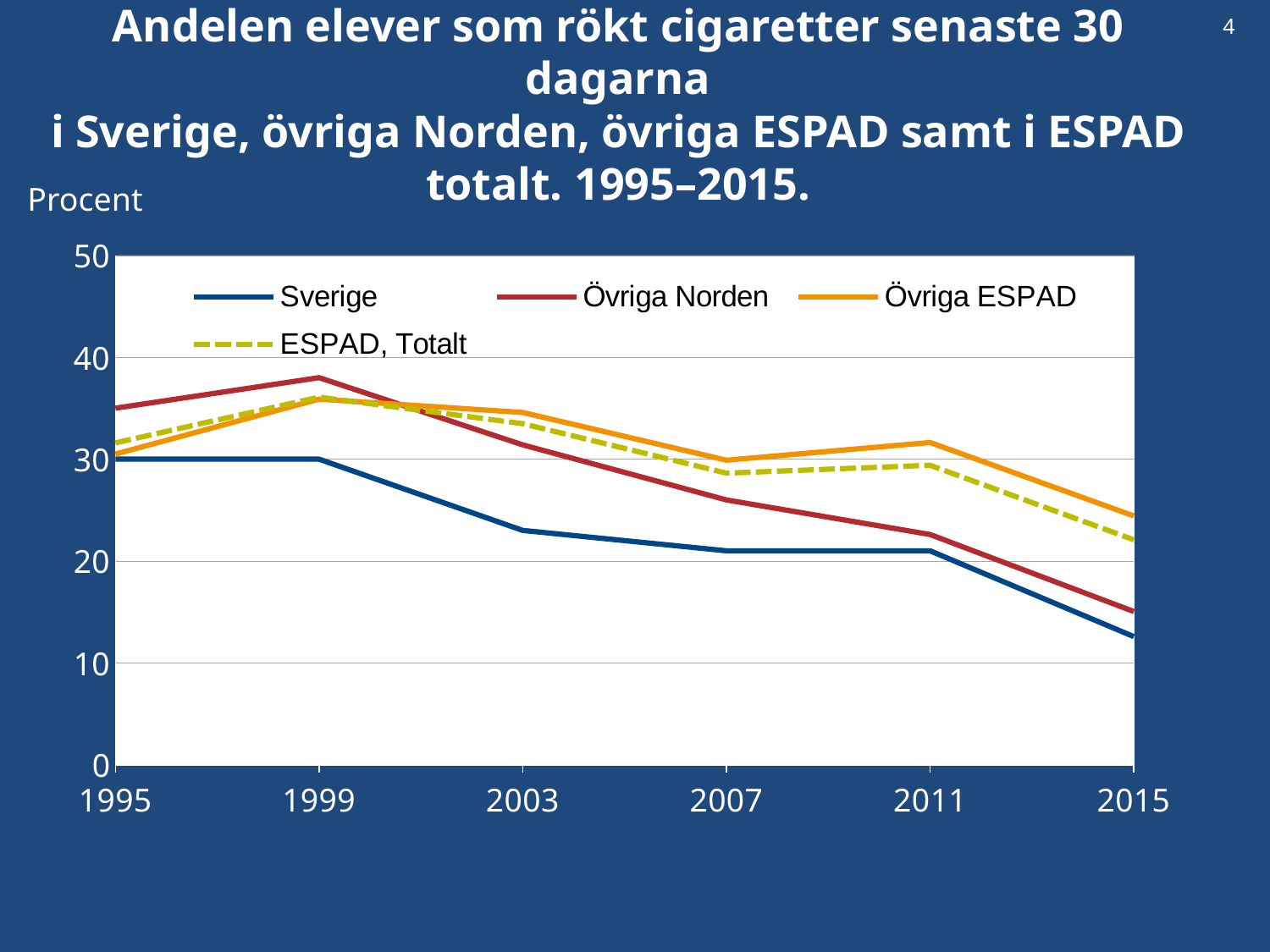
Is the value for Övriga ESPAD in 2015 greater or less than 20? greater How many years are marked on the x axis? 6 Which series is drawn with a dashed line? ESPAD, Totalt Which series has the lowest value in 2007? Sverige In 2015, which is larger: Övriga ESPAD or Sverige? Övriga ESPAD Does the value for Sverige rise or fall from 1995 to 2015? fall Which series has the highest value in 1999? Övriga Norden Is the value for Sverige in 2015 greater or less than 20? less In 2003, which is larger: Övriga Norden or Sverige? Övriga Norden How many series does the legend list? 4 What kind of chart is shown on the slide? line chart Is the value for Övriga Norden in 1999 greater or less than 30? greater